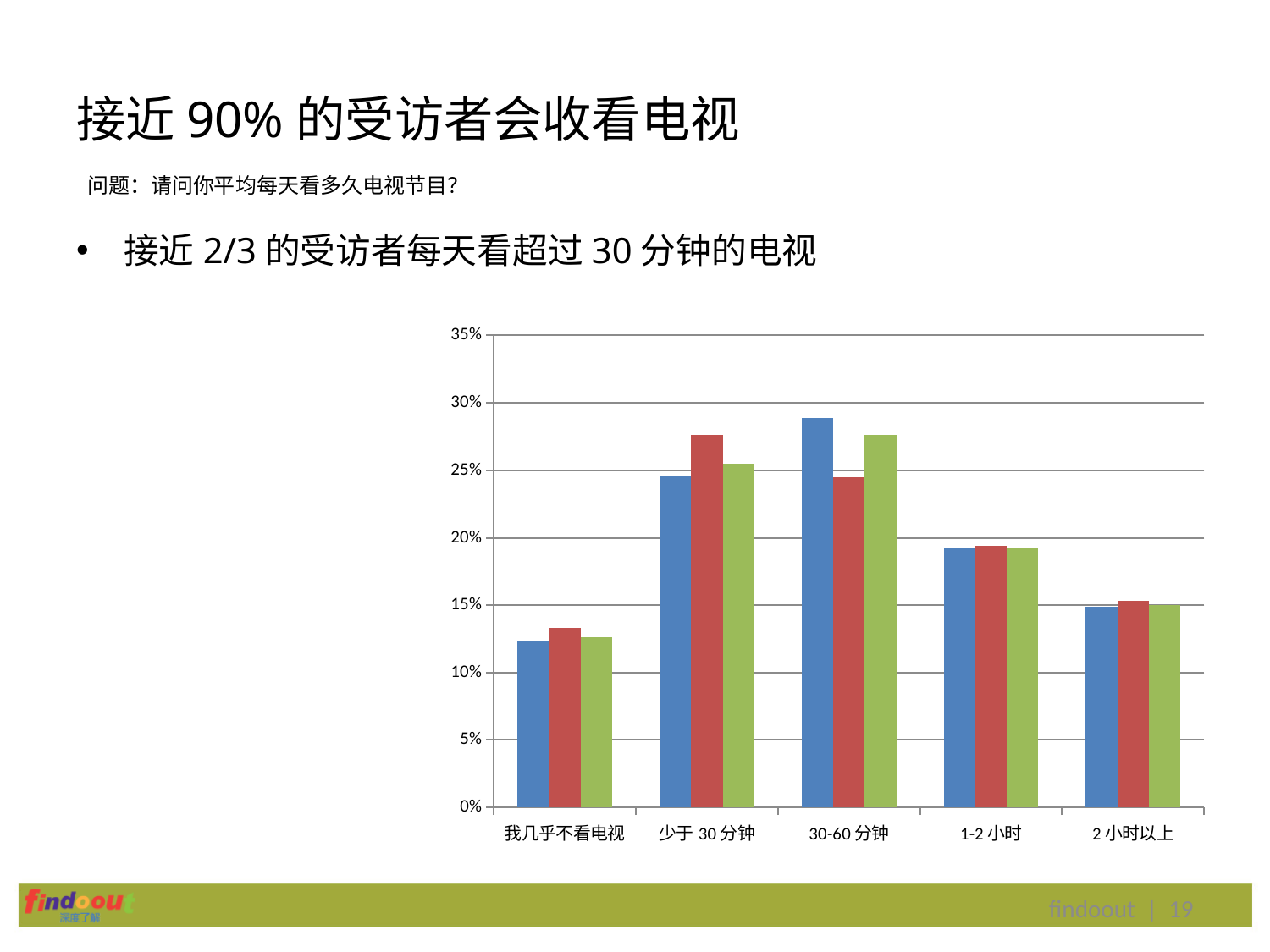
Is the blue bar for 30-60 分钟 greater or less than 25%? greater Which is larger: the red bar for 少于 30 分钟 or the red bar for 30-60 分钟? 少于 30 分钟 What kind of chart is shown on the slide? bar chart Which is larger: the blue bar for 30-60 分钟 or the blue bar for 少于 30 分钟? 30-60 分钟 Is the blue bar for 我几乎不看电视 greater or less than 15%? less Is the green bar for 2 小时以上 greater or less than 20%? less Which category has the tallest red bar? 少于 30 分钟 How many categories are shown on the x axis of the chart? 5 Which category has the tallest blue bar? 30-60 分钟 How many bars (series) are plotted for each category in the chart? 3 Which category has the lowest values across all three bars? 我几乎不看电视